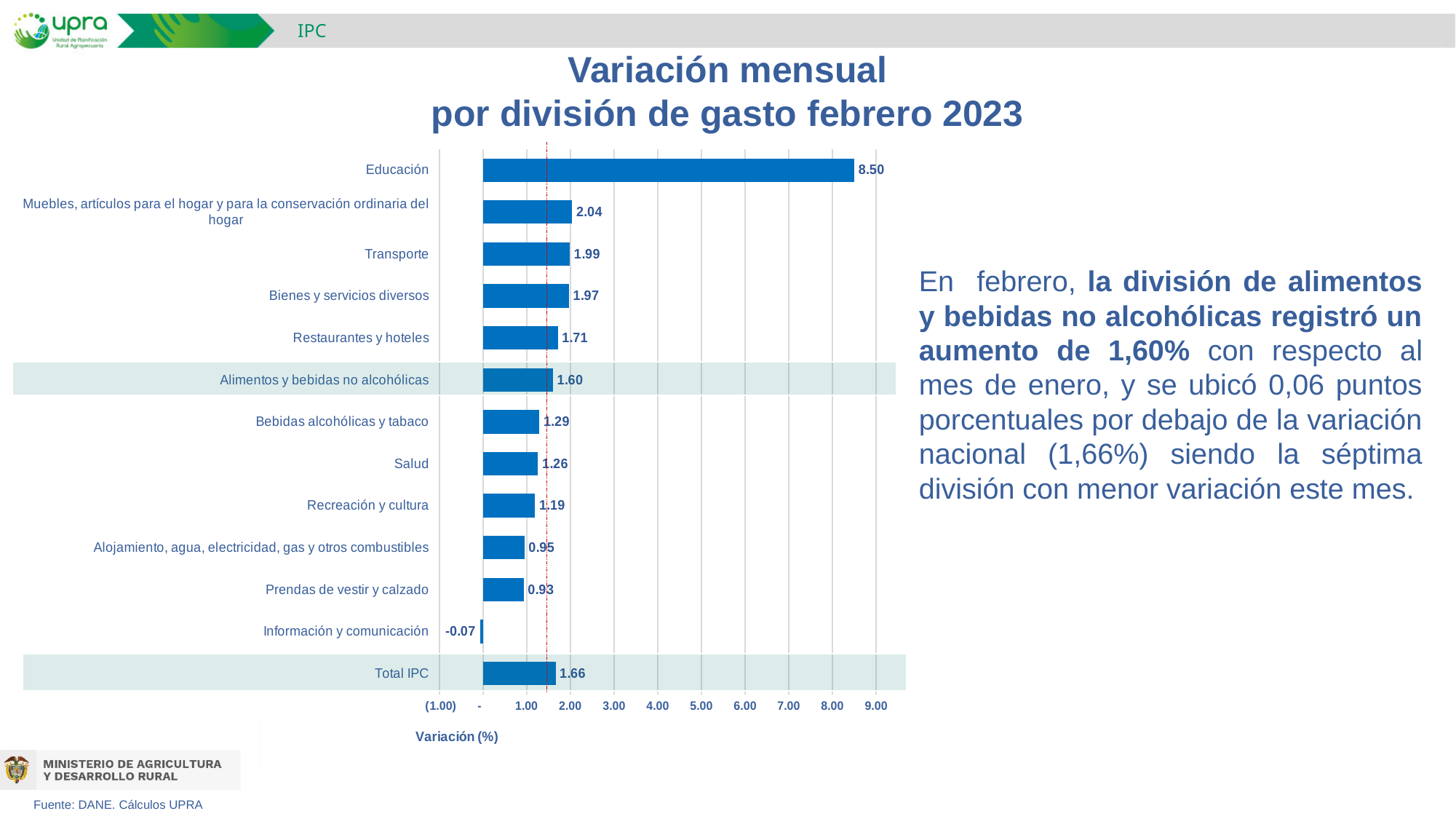
What is the value for Información y comunicación? -0.07 Is the value for Restaurantes y hoteles greater or less than 2.00? less Which category has the lowest value? Información y comunicación What is the value for Educación? 8.50 How many categories are shown in the chart? 13 What is the value for Total IPC? 1.66 What kind of chart is shown on the slide? bar chart Which category has the highest value? Educación What is the label of the horizontal axis? Variación (%) What is the difference between the values for Educación and Transporte? 6.51 Which is larger, the value for Salud or the value for Recreación y cultura? Salud What is the value for Alimentos y bebidas no alcohólicas? 1.60